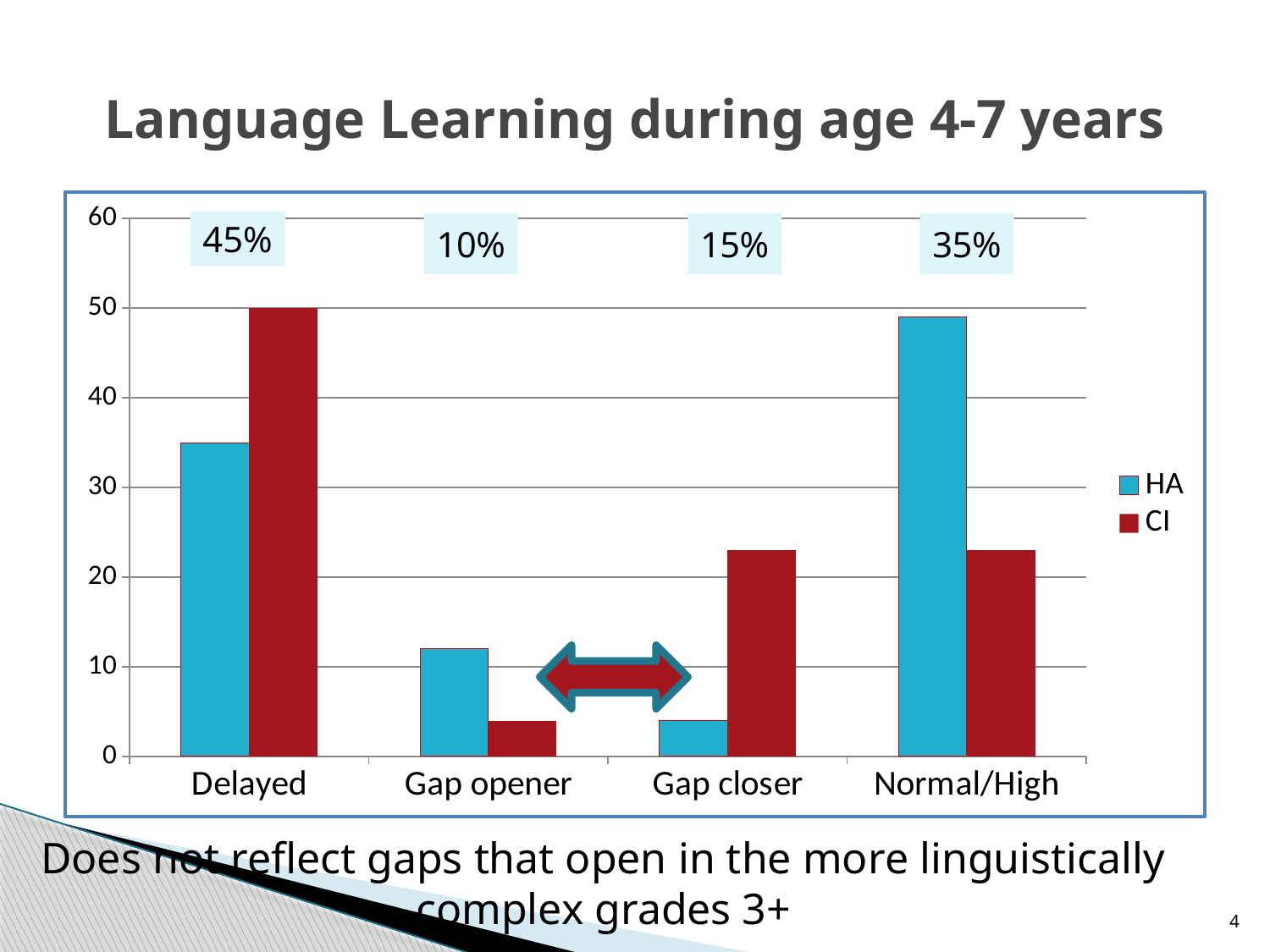
Which category has the lowest CI value? Gap opener For the Delayed category, which series has the larger value, HA or CI? CI Which category has the lowest HA value? Gap closer Which category has the highest HA value? Normal/High Which category has the highest CI value? Delayed Is the HA value for Gap opener greater or less than 10? greater How many series does the chart's legend list? 2 For the Normal/High category, which series has the larger value, HA or CI? HA What type of chart is shown on the slide? bar chart How many categories are shown on the x axis of the chart? 4 What is the CI value for the Delayed category? 50 Is the CI value for Gap closer greater or less than 20? greater